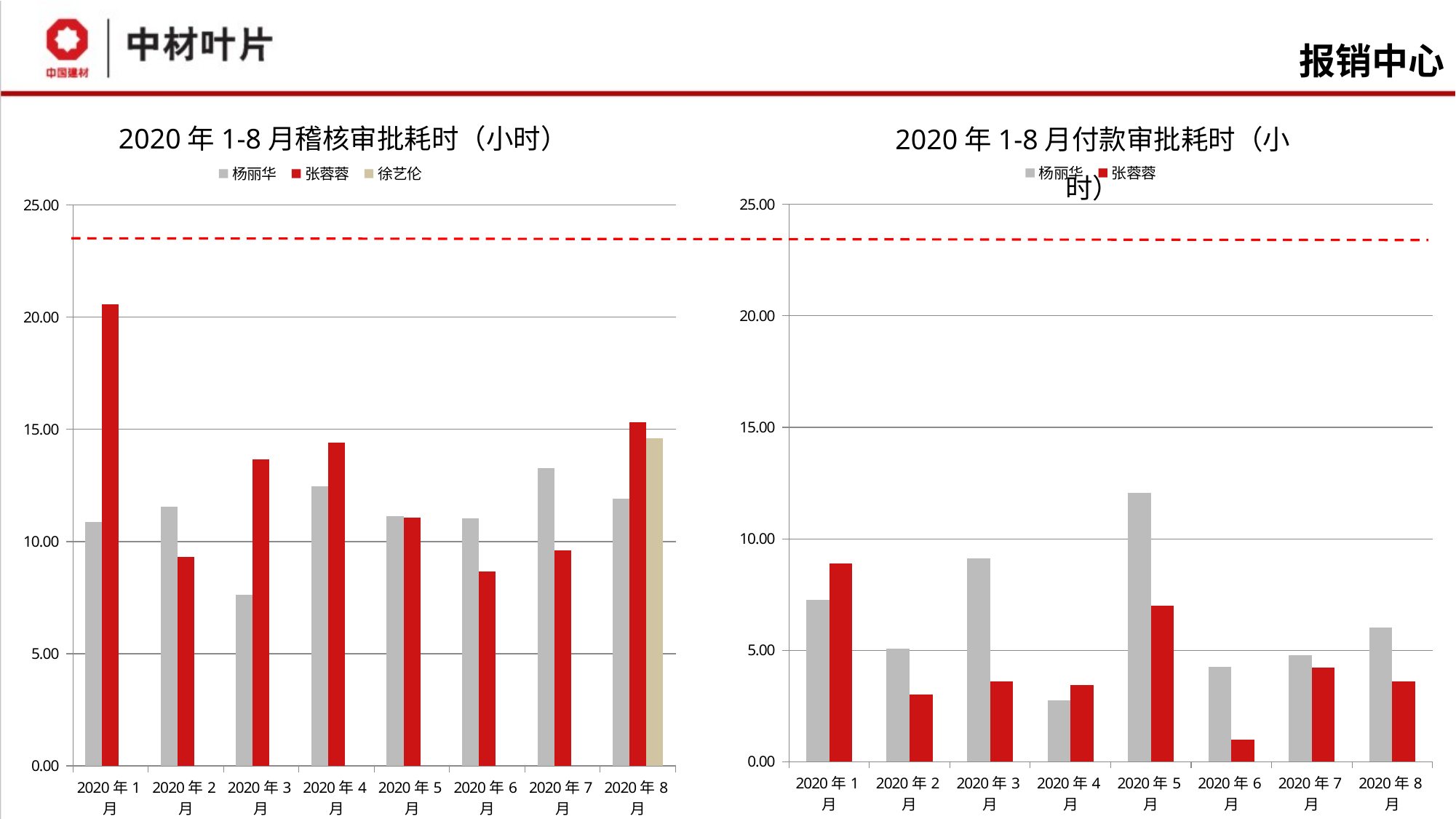
How many series does the legend of the left chart (2020年1-8月稽核审批耗时) list? 3 In the left chart (2020年1-8月稽核审批耗时), in which month is the value for 张蓉蓉 highest? 2020年1月 In the left chart (2020年1-8月稽核审批耗时), which series appears only in 2020年8月? 徐艺伦 In the right chart (2020年1-8月付款审批耗时), which is larger in 2020年3月, 杨丽华 or 张蓉蓉? 杨丽华 In the right chart (2020年1-8月付款审批耗时), in which month is the value for 张蓉蓉 lowest? 2020年6月 What kind of chart is the left chart, 2020年1-8月稽核审批耗时（小时）? bar chart In the left chart (2020年1-8月稽核审批耗时), is the value for 张蓉蓉 in 2020年1月 greater or less than 20.00? greater In the left chart (2020年1-8月稽核审批耗时), is the value for 杨丽华 in 2020年3月 greater or less than 10.00? less In the right chart (2020年1-8月付款审批耗时), is the value for 杨丽华 in 2020年5月 greater or less than 10.00? greater How many series does the legend of the right chart (2020年1-8月付款审批耗时) list? 2 In the left chart (2020年1-8月稽核审批耗时), in which month is the value for 杨丽华 lowest? 2020年3月 How many months are shown on the x axis of the right chart (2020年1-8月付款审批耗时)? 8